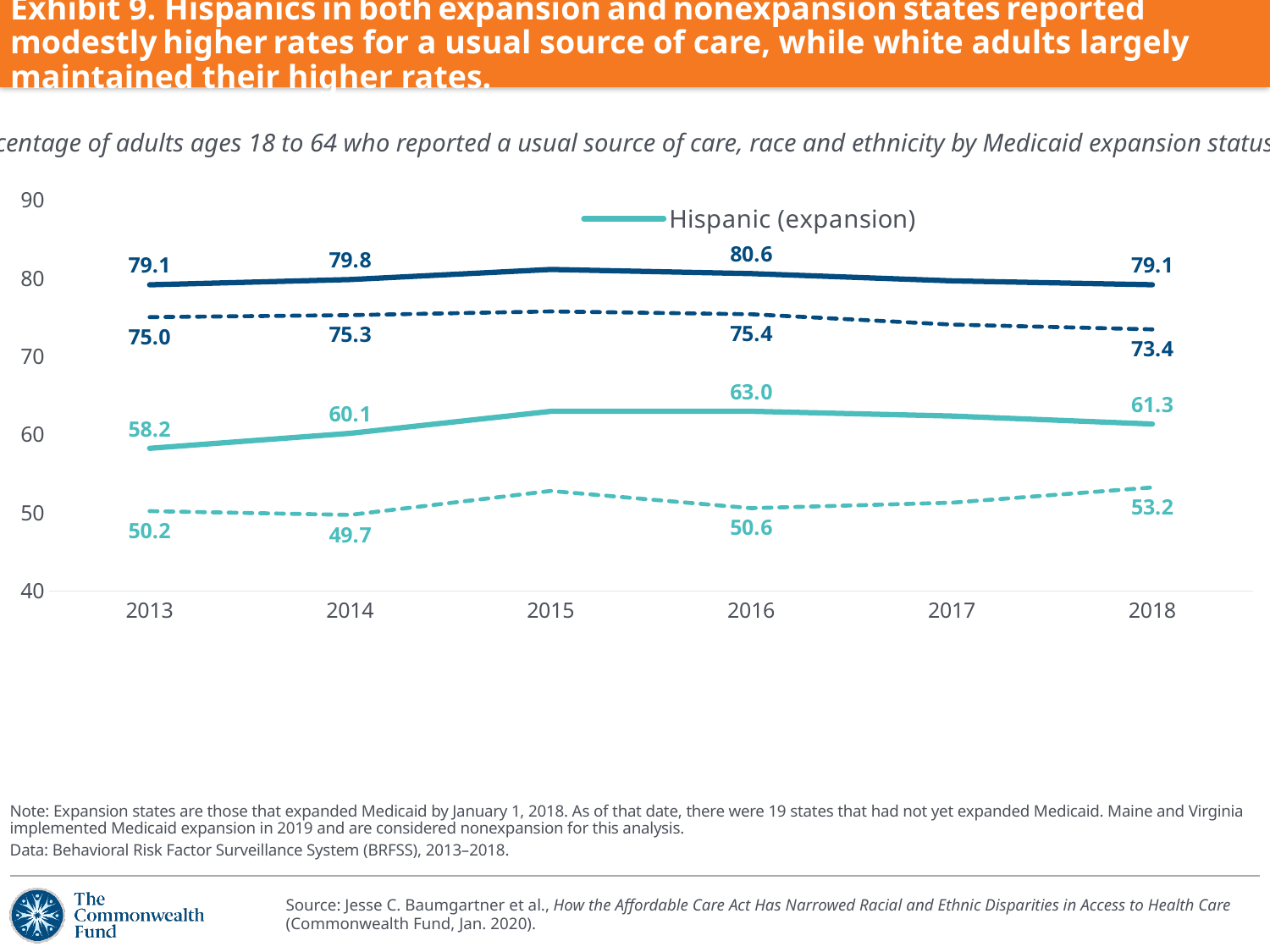
In which year is the Hispanic (expansion) value lowest? 2013 What is the value for Hispanic (expansion) in 2013? 58.2 Which is larger for Hispanic (expansion): the 2014 value or the 2018 value? 2018 Is the Hispanic (expansion) value for 2015 greater or less than 60? greater What is the value for Hispanic (expansion) in 2018? 61.3 What is the difference between the Hispanic (expansion) values in 2016 and 2013? 4.8 What is the value for Hispanic (expansion) in 2016? 63.0 What series name is shown in the chart legend? Hispanic (expansion) What is the value for Hispanic (expansion) in 2014? 60.1 What kind of chart is shown on the slide? Line chart How many years are shown on the x axis? 6 Does the Hispanic (expansion) line rise or fall from 2013 to 2016? Rise